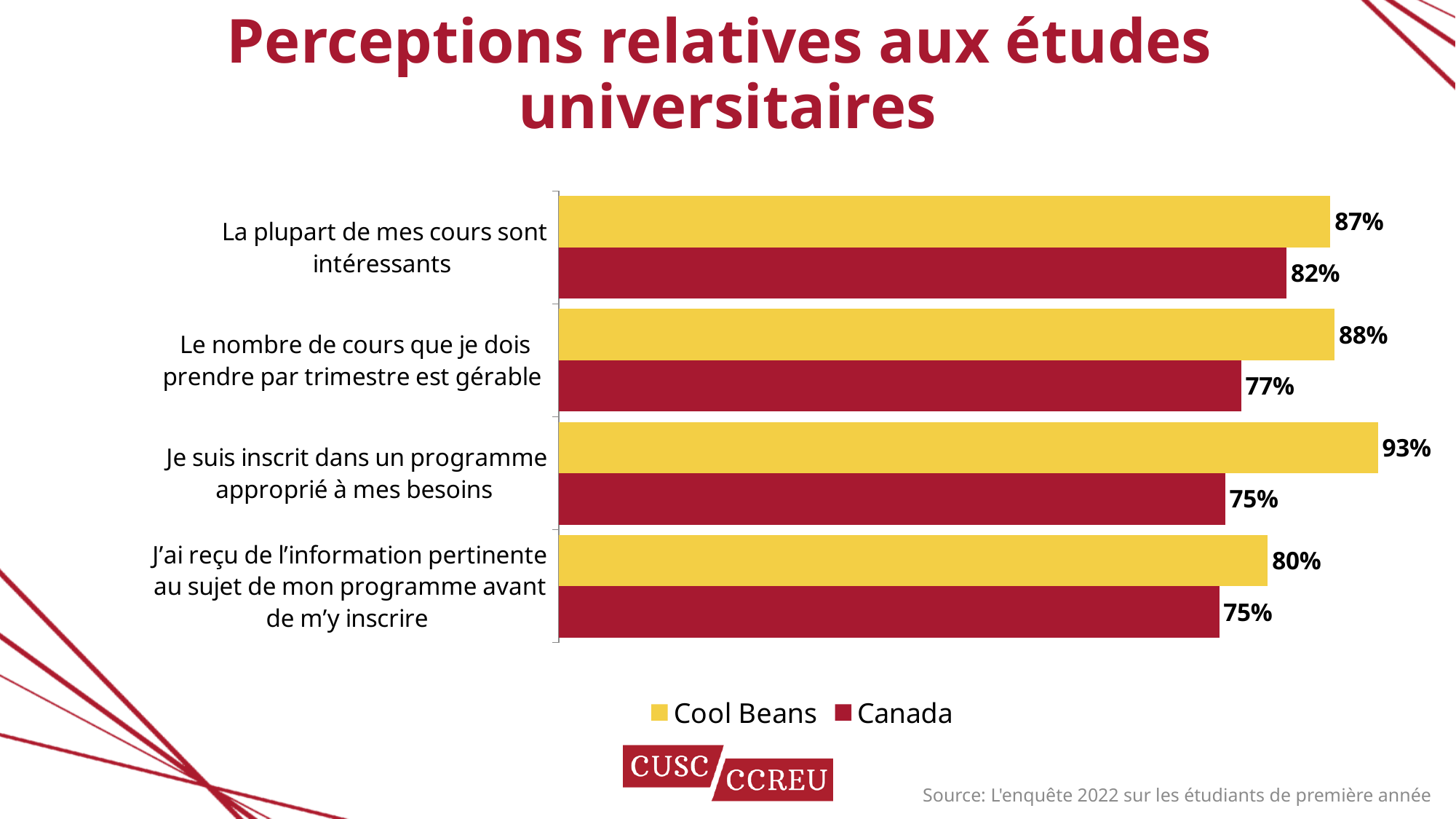
For "Le nombre de cours que je dois prendre par trimestre est gérable", which series has the larger value, Cool Beans or Canada? Cool Beans What is the Canada value for "Le nombre de cours que je dois prendre par trimestre est gérable"? 77% Which category has the highest Cool Beans value? Je suis inscrit dans un programme approprié à mes besoins Which category has the highest Canada value? La plupart de mes cours sont intéressants How many series does the legend list? 2 What is the difference between the Cool Beans and Canada values for "Je suis inscrit dans un programme approprié à mes besoins"? 18% Which category has the lowest Cool Beans value? J'ai reçu de l'information pertinente au sujet de mon programme avant de m'y inscrire What is the Cool Beans value for "Je suis inscrit dans un programme approprié à mes besoins"? 93% How many categories are shown in the chart? 4 What is the Canada value for "J'ai reçu de l'information pertinente au sujet de mon programme avant de m'y inscrire"? 75% What is the Cool Beans value for "La plupart de mes cours sont intéressants"? 87% What kind of chart is shown on the slide? Bar chart